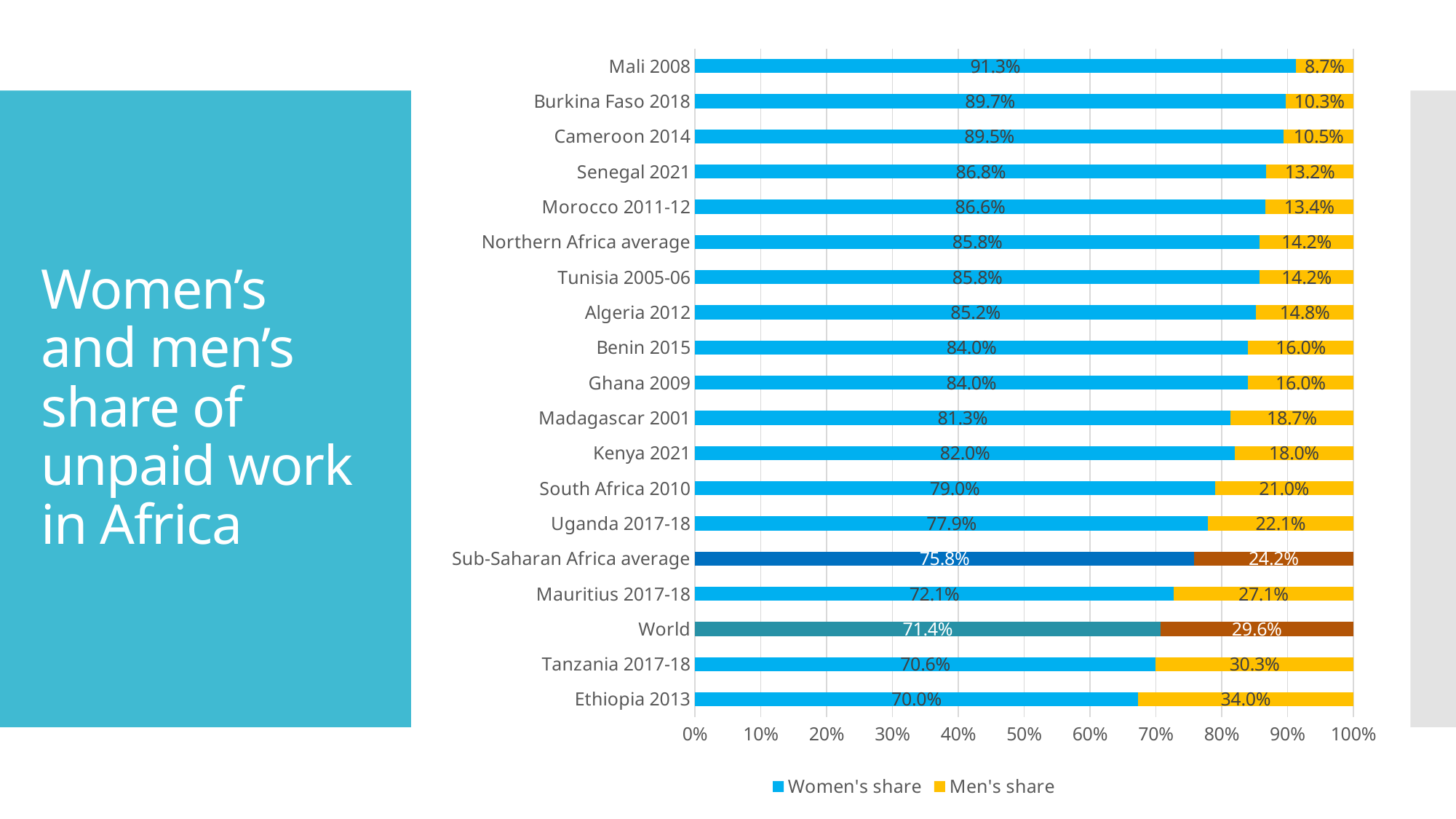
Which category has the lowest women's share? Ethiopia 2013 How many series does the legend list? 2 Which category has the highest men's share? Ethiopia 2013 Which has a larger men's share, Tanzania 2017-18 or Mauritius 2017-18? Tanzania 2017-18 How many categories are shown on the chart? 19 What is the title of the slide? Women's and men's share of unpaid work in Africa What kind of chart is shown on the slide? Stacked bar chart What is the women's share for Senegal 2021? 86.8% Which category has the highest women's share? Mali 2008 What is the women's share for the World? 71.4% What is the men's share for South Africa 2010? 21.0% What is the difference in women's share between Mali 2008 and Ethiopia 2013? 21.3 percentage points